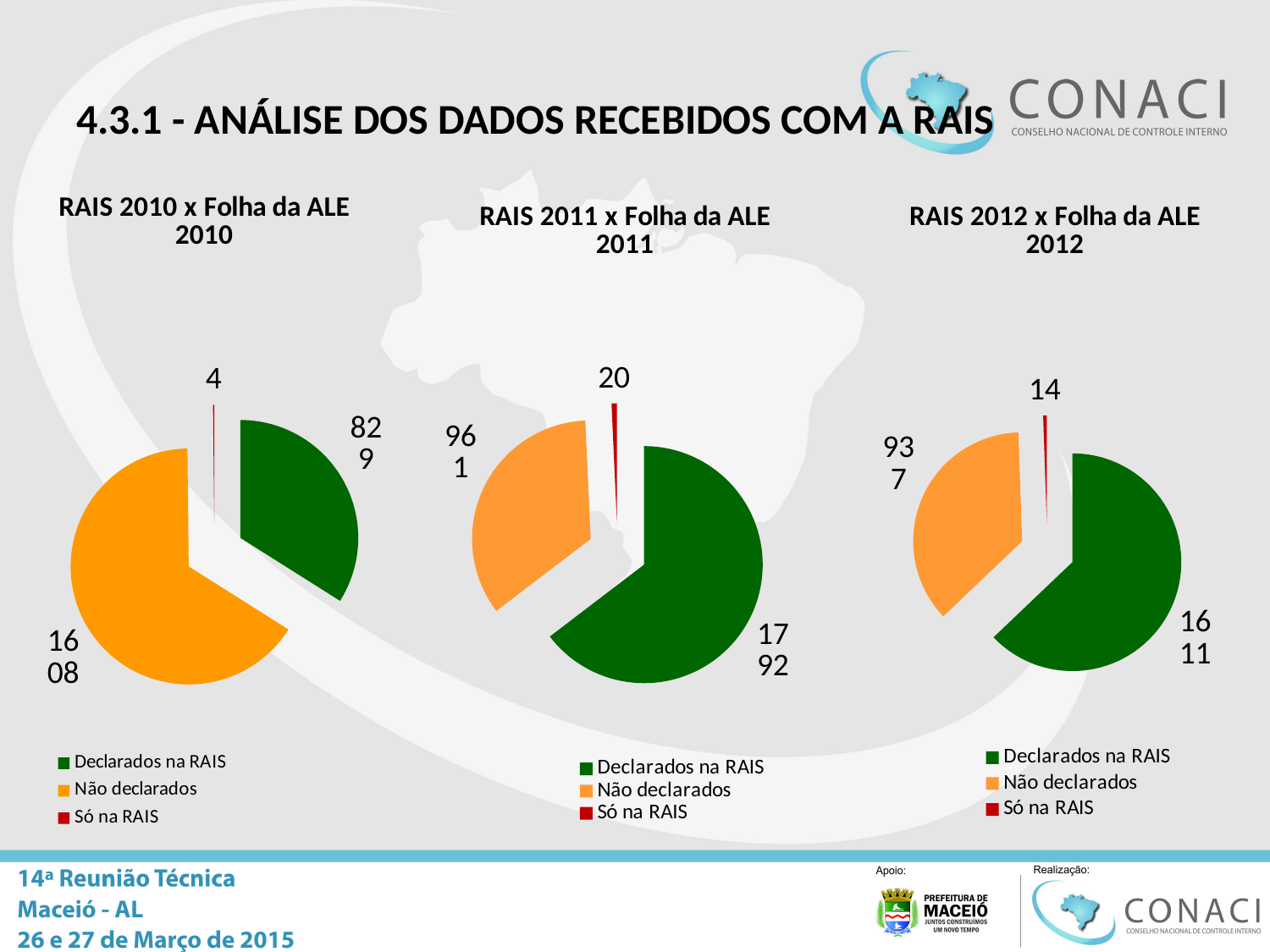
How many categories does the legend of the 'RAIS 2011 x Folha da ALE 2011' chart list? 3 How many pie charts are on the slide? 3 In the 'RAIS 2010 x Folha da ALE 2010' chart, which category has the largest slice? Não declarados In the 'RAIS 2011 x Folha da ALE 2011' chart, which is larger: 'Declarados na RAIS' or 'Não declarados'? Declarados na RAIS In the 'RAIS 2010 x Folha da ALE 2010' chart, what is the value for 'Não declarados'? 1608 In the 'RAIS 2012 x Folha da ALE 2012' chart, which category has the smallest slice? Só na RAIS What type of charts are shown on the slide? Pie charts In the 'RAIS 2010 x Folha da ALE 2010' chart, what is the value for 'Só na RAIS'? 4 In the 'RAIS 2012 x Folha da ALE 2012' chart, what is the value for 'Só na RAIS'? 14 In the 'RAIS 2011 x Folha da ALE 2011' chart, what is the value for 'Declarados na RAIS'? 1792 In the 'RAIS 2010 x Folha da ALE 2010' chart, what colour is the 'Não declarados' slice? Orange In the 'RAIS 2012 x Folha da ALE 2012' chart, what is the difference between 'Declarados na RAIS' and 'Não declarados'? 674